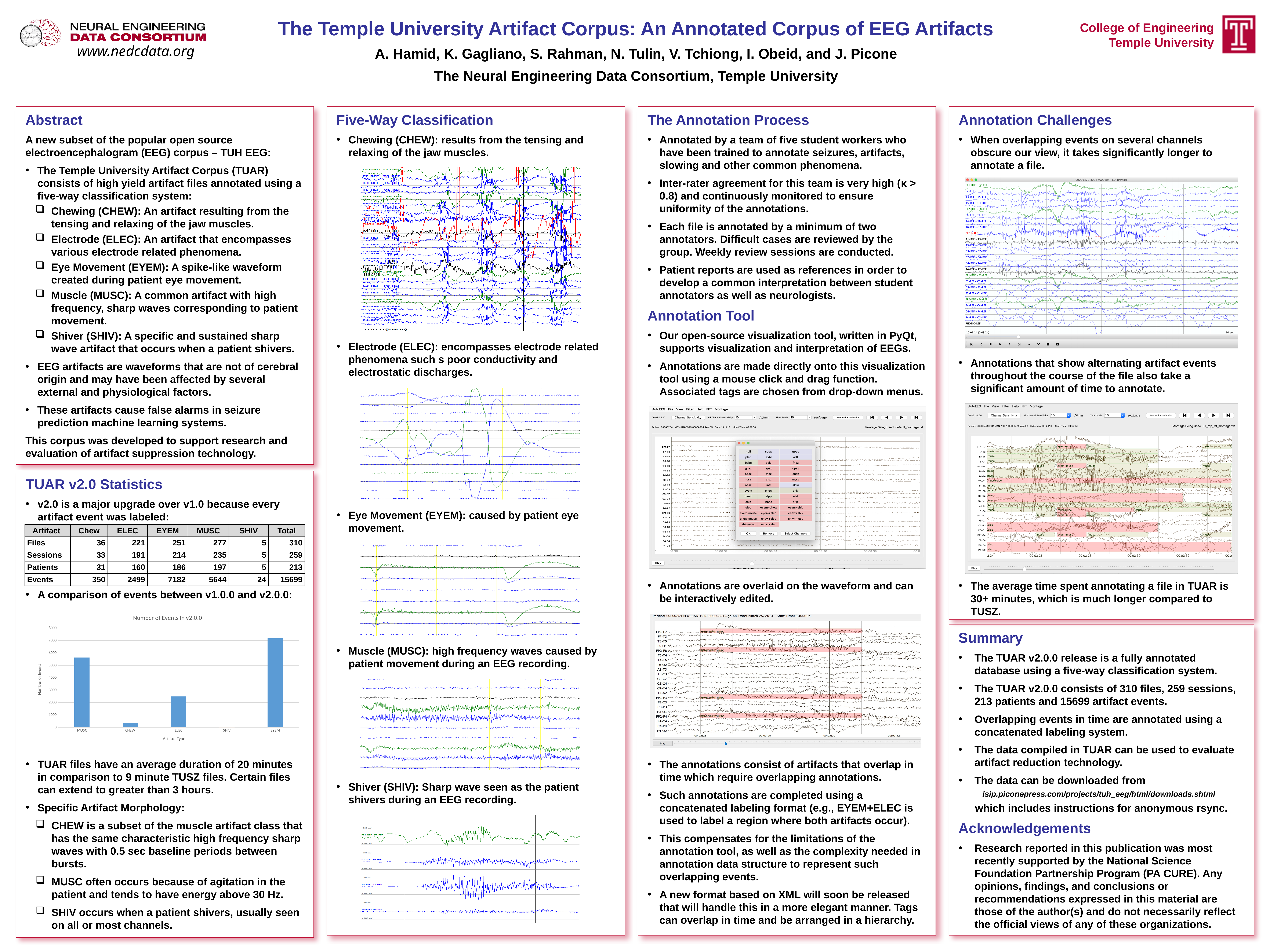
What type of chart is used to show the number of events in v2.0.0? bar chart What is the x-axis label of the bar chart? Artifact Type What is the title of the bar chart in the TUAR v2.0 Statistics section? Number of Events In v2.0.0 In the bar chart, is the value for ELEC greater or less than 3000? less How many artifact types are shown on the x axis of the bar chart? 5 In the bar chart, which has more events, MUSC or ELEC? MUSC Which artifact type has the highest number of events in the bar chart? EYEM In the bar chart, which has more events, CHEW or ELEC? ELEC In the bar chart, is the value for MUSC greater or less than 5000? greater In the bar chart, is the value for EYEM greater or less than 6000? greater Which artifact type has the lowest number of events in the bar chart? SHIV